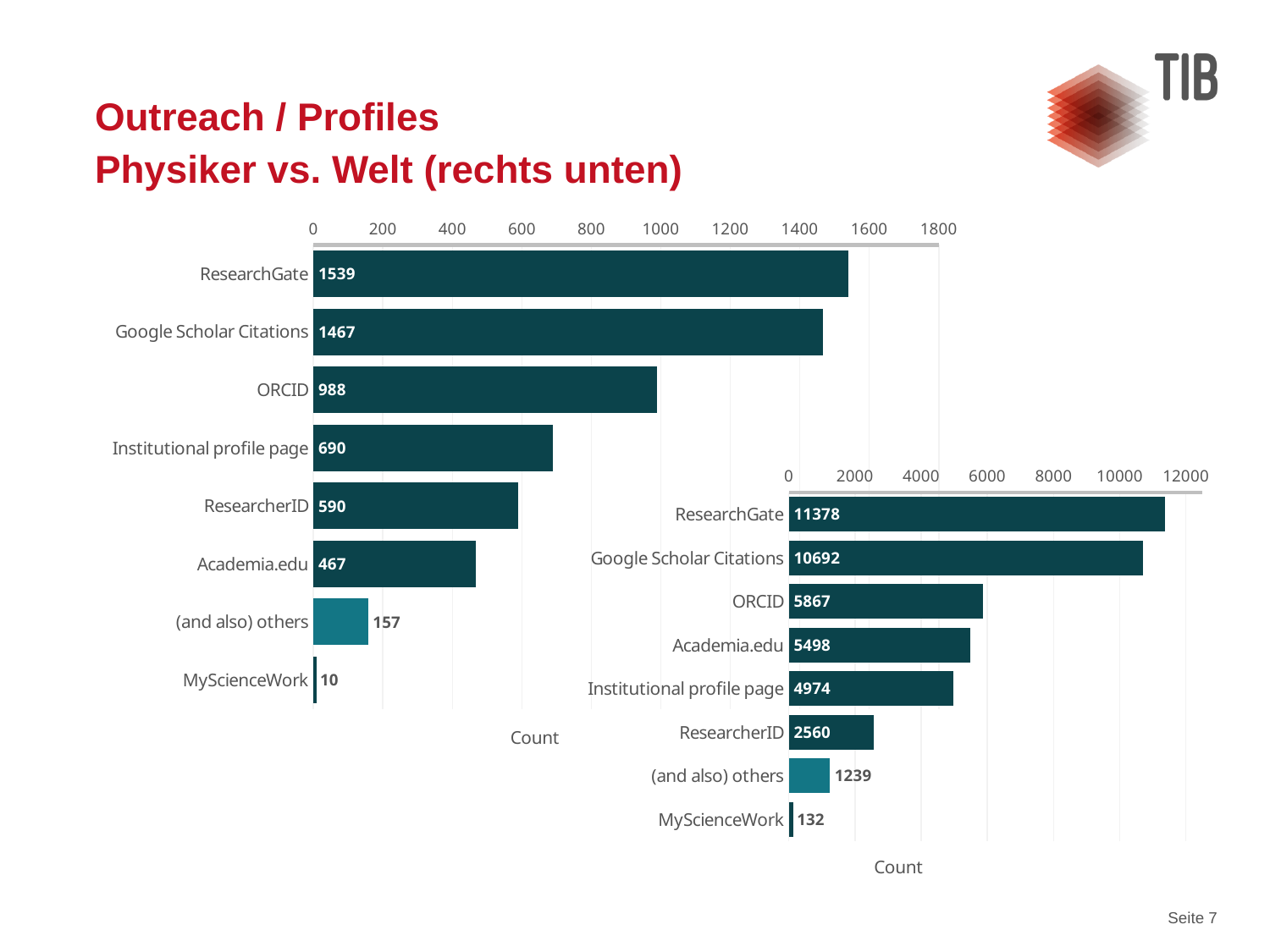
In the left chart (Physiker), what is the count for (and also) others? 157 What is the label on the horizontal axis of the right chart (Welt, bottom right)? Count In the left chart (Physiker), is the value for Institutional profile page greater or less than 600? greater How many categories are shown in the left chart (Physiker)? 8 In the right chart (Welt, bottom right), what is the difference between the counts for ORCID and Academia.edu? 369 In the left chart (Physiker), what is the count for ORCID? 988 In the right chart (Welt, bottom right), which category has the lowest count? MyScienceWork In the right chart (Welt, bottom right), what is the count for Academia.edu? 5498 In the left chart (Physiker), what is the difference between the counts for ResearchGate and Google Scholar Citations? 72 What kind of chart is the right chart (Welt, bottom right)? Bar chart In the right chart (Welt, bottom right), which has a higher count, Institutional profile page or ResearcherID? Institutional profile page In the left chart (Physiker), which category has the highest count? ResearchGate